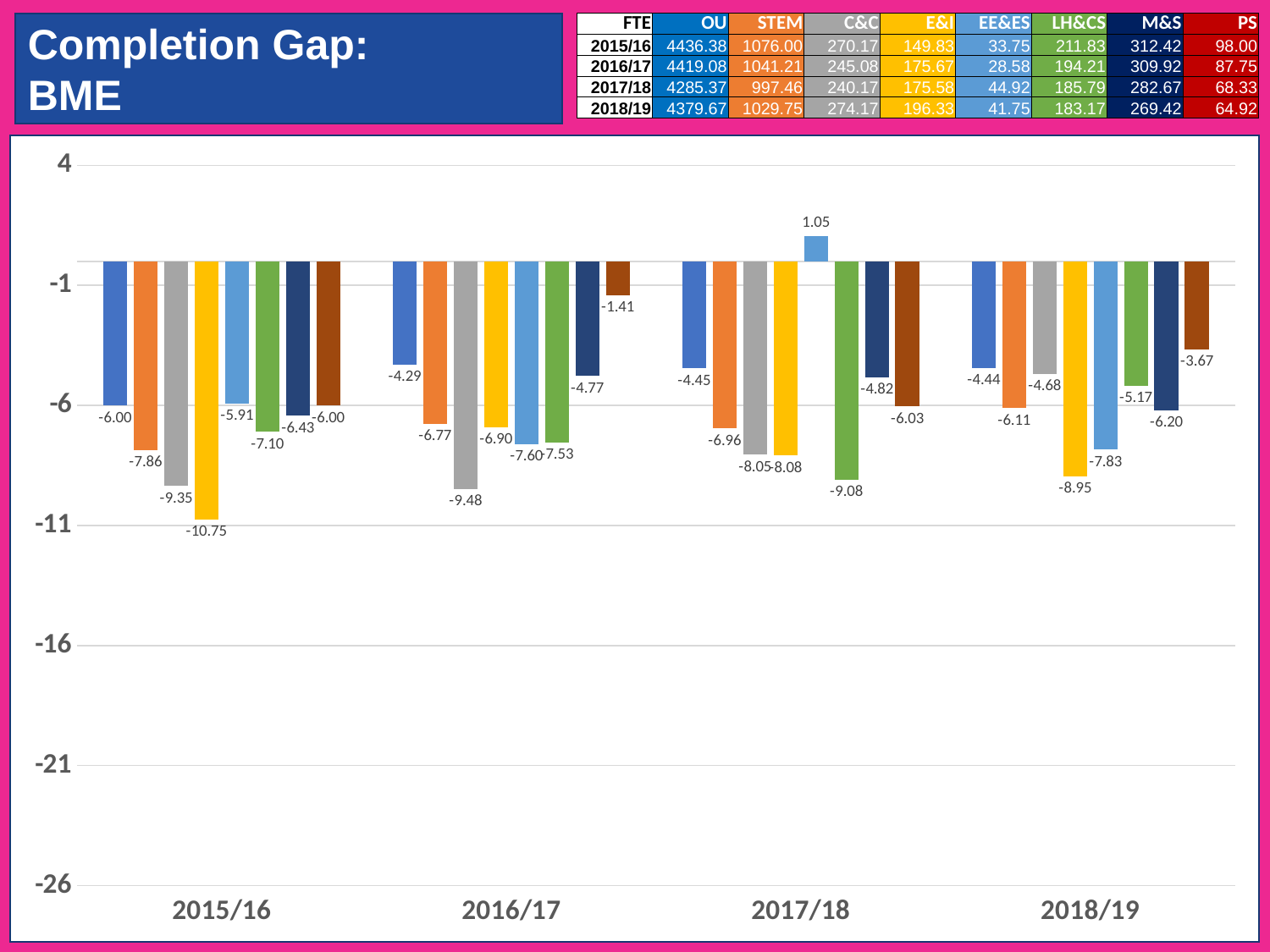
What kind of chart is shown on the slide? bar chart What is the value of the light blue bar in the 2017/18 group? 1.05 What is the value of the dark red/brown bar in the 2016/17 group? -1.41 In the 2018/19 group, which is lower: the yellow bar or the light blue bar? the yellow bar (-8.95) How many academic-year groups are shown along the x axis of the chart? 4 In the 2016/17 group, what is the difference between the grey bar (-9.48) and the dark red/brown bar (-1.41)? 8.07 What is the value of the yellow bar in the 2015/16 group? -10.75 What is the title of the slide containing the chart? Completion Gap: BME Is the value of the green bar in the 2017/18 group greater or less than -6? less How many bars are plotted in each year group of the chart? 8 What is the highest value plotted on the chart? 1.05 Which year group contains the lowest value on the chart, and what is it? 2015/16, -10.75